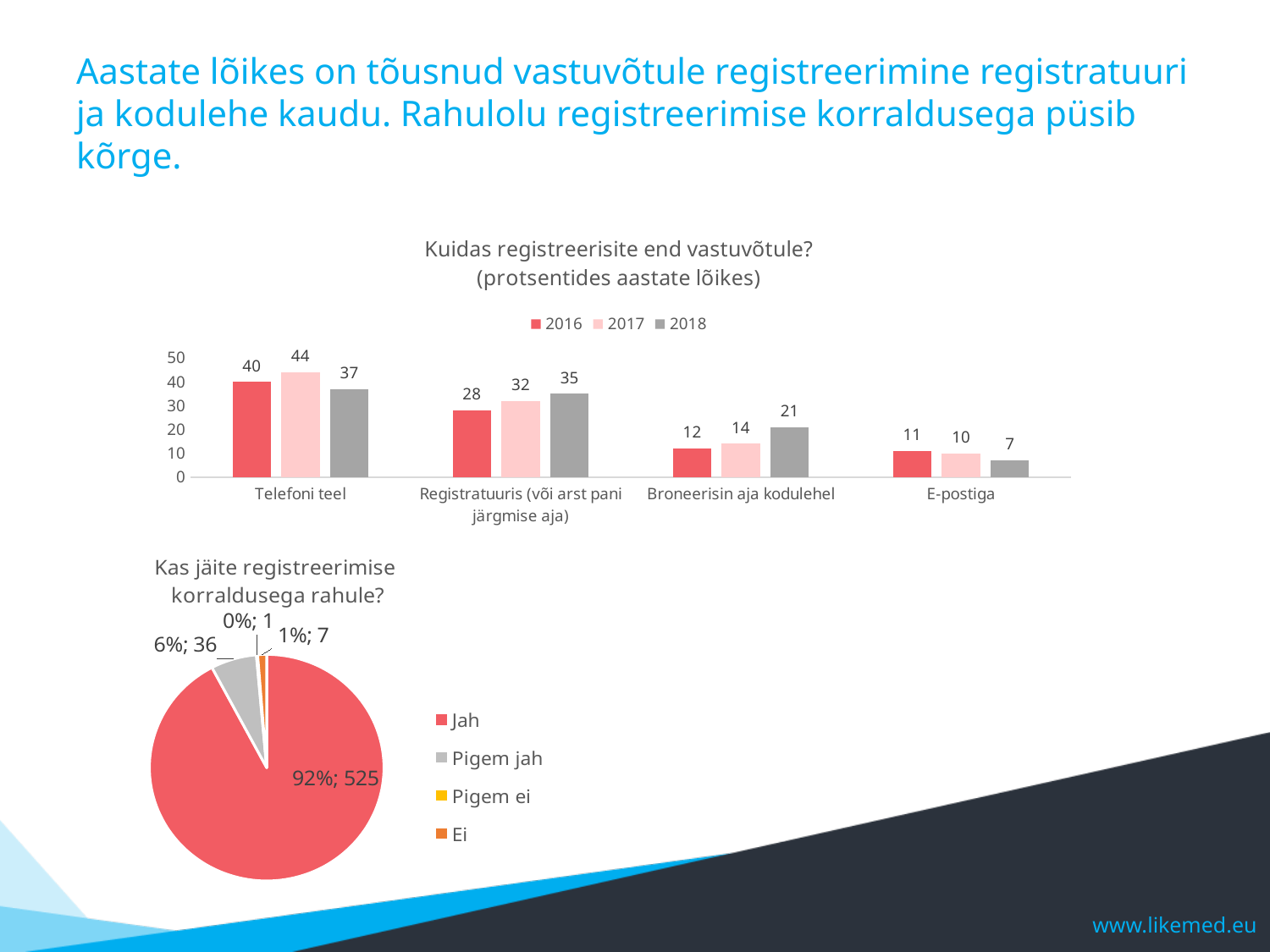
How many categories are shown on the x axis of the bar chart 'Kuidas registreerisite end vastuvõtule?'? 4 In the bar chart 'Kuidas registreerisite end vastuvõtule?', what is the difference between the 2018 and 2016 values for 'Broneerisin aja kodulehel'? 9 How many series does the legend of the bar chart 'Kuidas registreerisite end vastuvõtule?' list? 3 In the bar chart 'Kuidas registreerisite end vastuvõtule?', what is the value for 'E-postiga' in 2016? 11 In the bar chart 'Kuidas registreerisite end vastuvõtule?', what is the value for 'Telefoni teel' in 2017? 44 In the pie chart 'Kas jäite registreerimise korraldusega rahule?', what is the count shown for 'Pigem jah'? 36 In the pie chart 'Kas jäite registreerimise korraldusega rahule?', what share of the pie is 'Jah'? 92% In the bar chart 'Kuidas registreerisite end vastuvõtule?', what is the value for 'Broneerisin aja kodulehel' in 2018? 21 In the bar chart 'Kuidas registreerisite end vastuvõtule?', which category has the lowest value in 2018? E-postiga In the bar chart 'Kuidas registreerisite end vastuvõtule?', which category has the highest value in 2018? Telefoni teel In the bar chart 'Kuidas registreerisite end vastuvõtule?', do the values for 'E-postiga' rise or fall from 2016 to 2018? fall In the bar chart 'Kuidas registreerisite end vastuvõtule?', which is larger for 'Registratuuris (või arst pani järgmise aja)': the 2016 value or the 2018 value? 2018